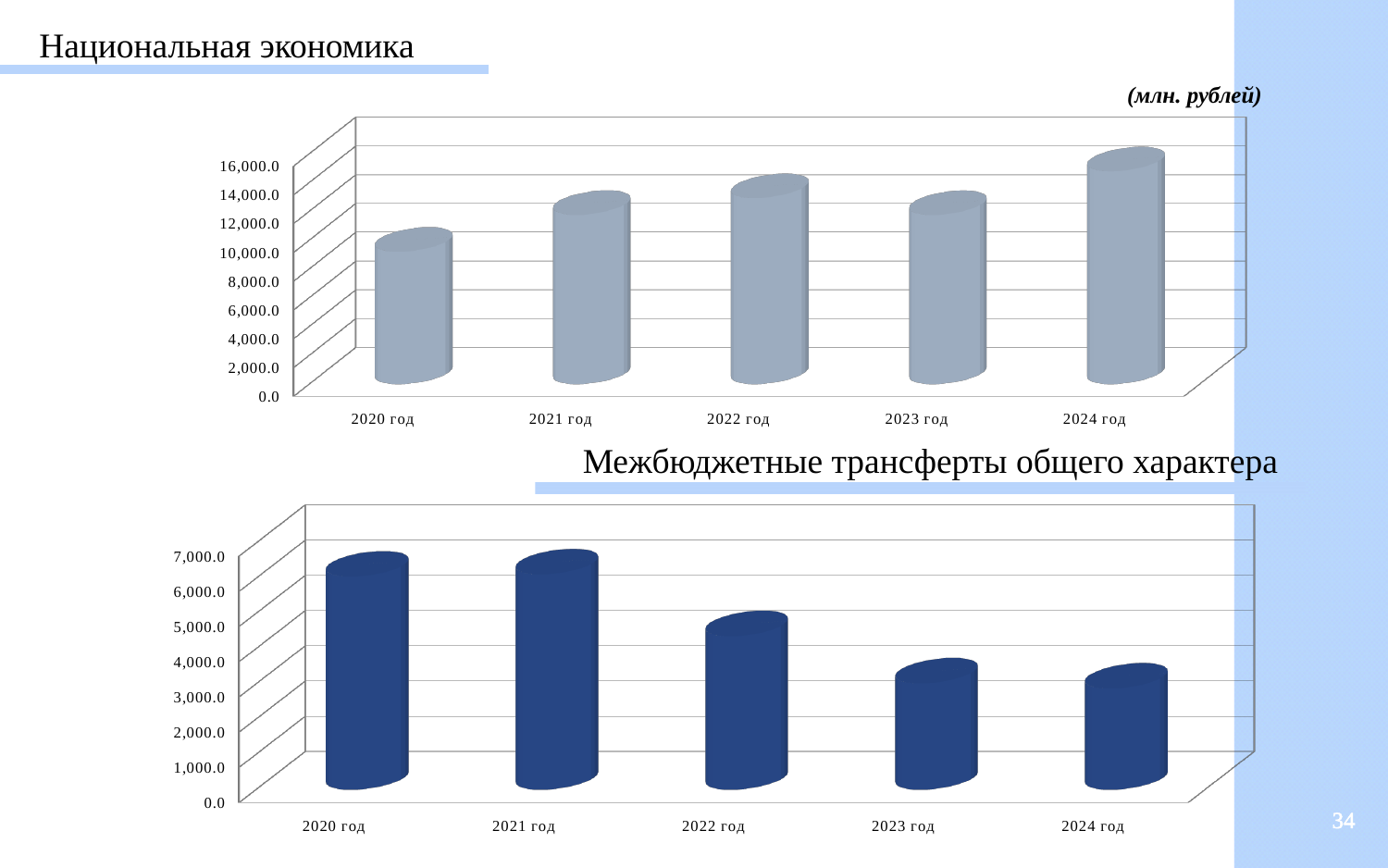
In the bottom chart "Межбюджетные трансферты общего характера", which is larger, the value for 2021 год or the value for 2023 год? 2021 год In the top chart "Национальная экономика", is the value for 2020 год greater or less than 12,000.0? less What unit is stated above the top chart "Национальная экономика"? (млн. рублей) What kind of chart is the top chart titled "Национальная экономика"? bar chart In the top chart "Национальная экономика", which year has the lowest value? 2020 год How many years are shown on the x axis of the top chart "Национальная экономика"? 5 In the top chart "Национальная экономика", which is larger, the value for 2022 год or the value for 2020 год? 2022 год In the top chart "Национальная экономика", is the value for 2024 год greater or less than 14,000.0? greater In the top chart "Национальная экономика", which year has the highest value? 2024 год In the bottom chart "Межбюджетные трансферты общего характера", do the values generally rise or fall from 2020 год to 2024 год? fall In the bottom chart "Межбюджетные трансферты общего характера", is the value for 2020 год greater or less than 5,000.0? greater